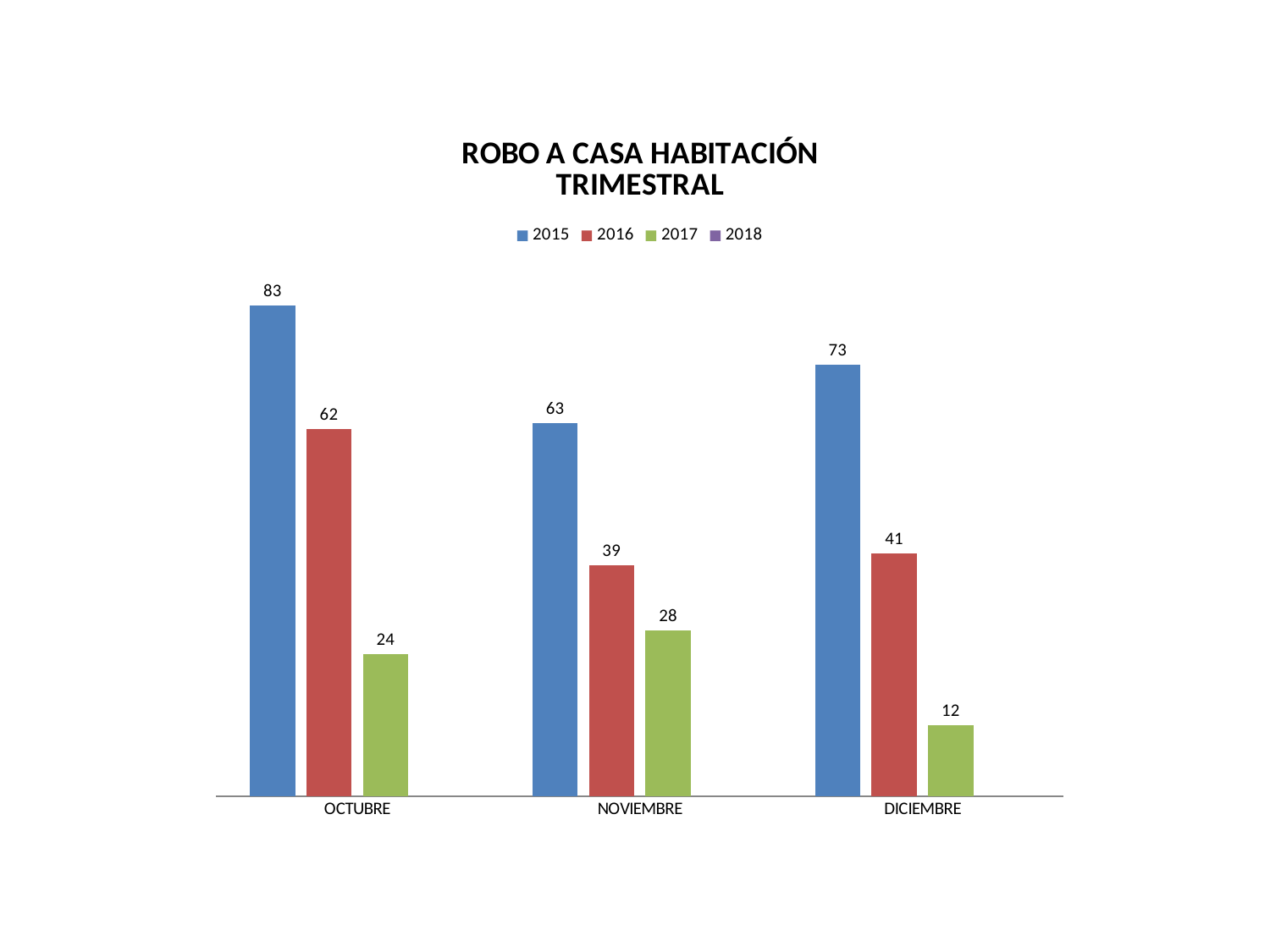
Which month has the lowest value for the 2017 series? DICIEMBRE What is the difference between the 2015 and 2016 values in DICIEMBRE? 32 What is the value for 2017 in DICIEMBRE? 12 Which month has the highest value for the 2015 series? OCTUBRE Which is larger, the 2016 value in OCTUBRE or the 2015 value in NOVIEMBRE? 2015 value in NOVIEMBRE What is the value for 2016 in NOVIEMBRE? 39 How many months are shown on the x axis? 3 What kind of chart is shown? Bar chart Does the 2016 series rise or fall from OCTUBRE to NOVIEMBRE? Fall What is the value for 2015 in OCTUBRE? 83 What is the title of the chart? ROBO A CASA HABITACIÓN TRIMESTRAL How many series does the legend list? 4